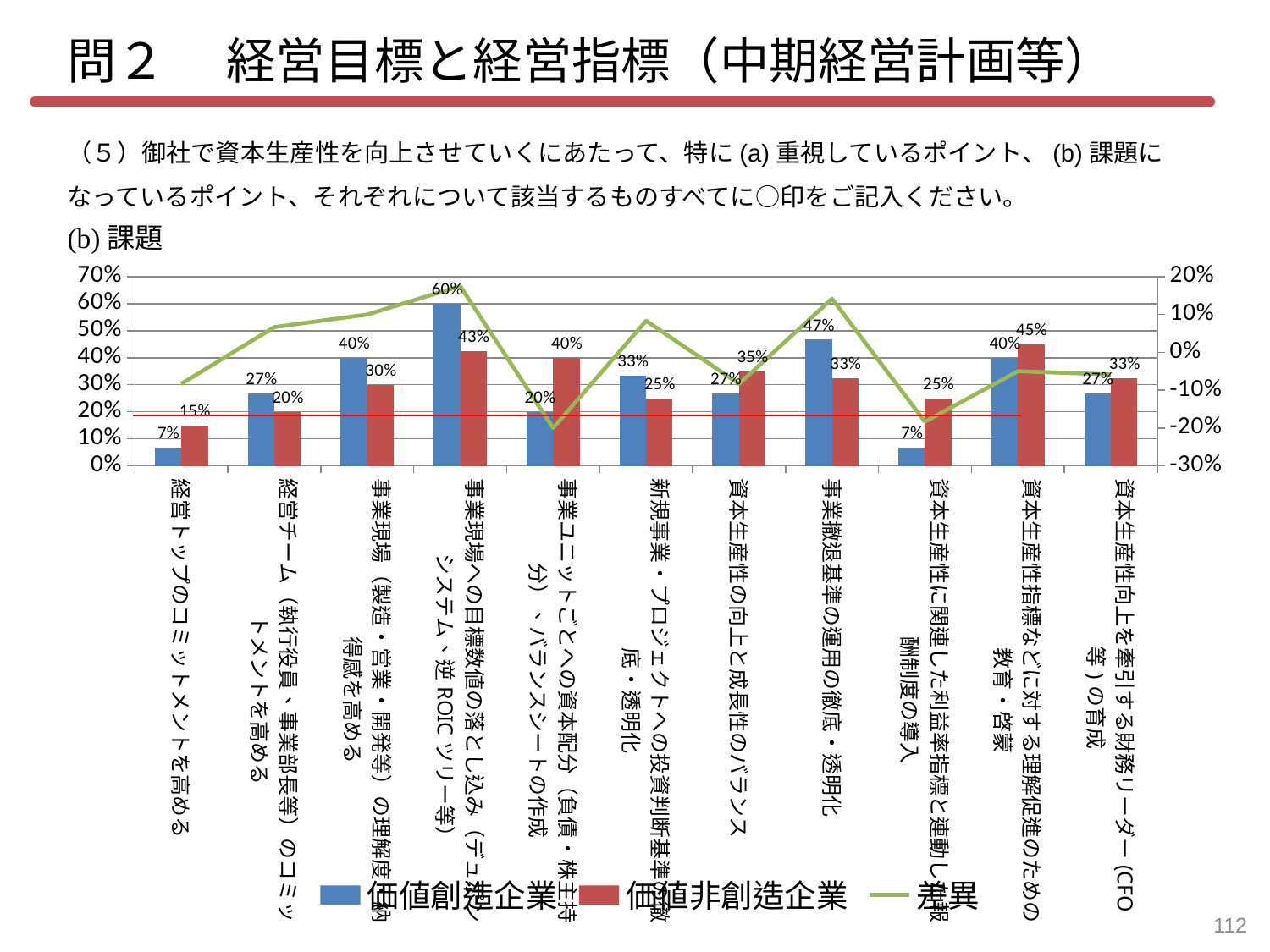
What is the value for 価値非創造企業 for 経営トップのコミットメントを高める? 15% What is the value for 価値創造企業 for 資本生産性に関連した利益率指標と連動した報酬制度の導入? 7% For 事業ユニットごとへの資本配分（負債・株主持分）、バランスシートの作成, which is larger: 価値創造企業 or 価値非創造企業? 価値非創造企業 How many series does the legend list? 3 Which category has the lowest value for 価値非創造企業? 経営トップのコミットメントを高める Which series is drawn as a line in the chart? 差異 What is the value for 価値創造企業 for 事業現場への目標数値の落とし込み（デュポンシステム、逆ROICツリー等）? 60% What kind of chart is this? Combination bar and line chart Which category has the highest value for 価値創造企業? 事業現場への目標数値の落とし込み（デュポンシステム、逆ROICツリー等） How many categories are shown on the x axis? 11 What is the value for 価値非創造企業 for 資本生産性指標などに対する理解促進のための教育・啓蒙? 45% What is the difference between 価値創造企業 and 価値非創造企業 for 事業撤退基準の運用の徹底・透明化? 14%